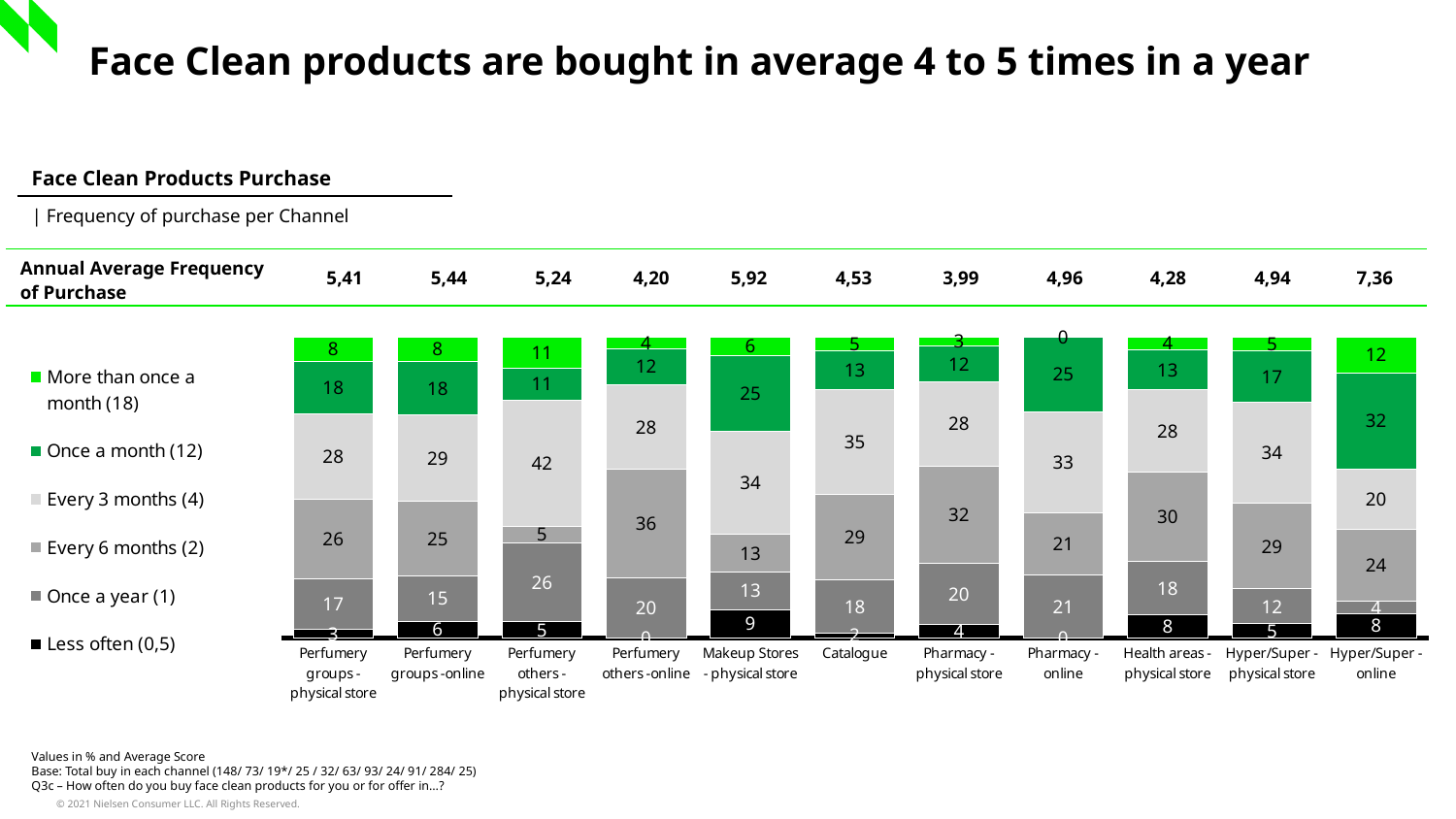
Which is larger: the 'More than once a month' value for Hyper/Super - online or for Perfumery groups - physical store? Hyper/Super - online How many series does the legend list? 6 What is the Annual Average Frequency of Purchase for Makeup Stores - physical store? 5,92 Which channel has the highest Annual Average Frequency of Purchase? Hyper/Super - online What is the value for 'Every 6 months' in the Perfumery others - online bar? 36 Which channel has the lowest Annual Average Frequency of Purchase? Pharmacy - physical store What is the title of the chart? Face Clean Products Purchase What is the difference between the 'Every 3 months' values for Catalogue and Pharmacy - physical store? 7 What percentage of Perfumery others - physical store buyers purchase Every 3 months? 42 What is the value for 'Once a month' in the Hyper/Super - online bar? 32 What kind of chart is shown on the slide? Stacked bar chart How many channels (categories) are plotted in the chart? 11